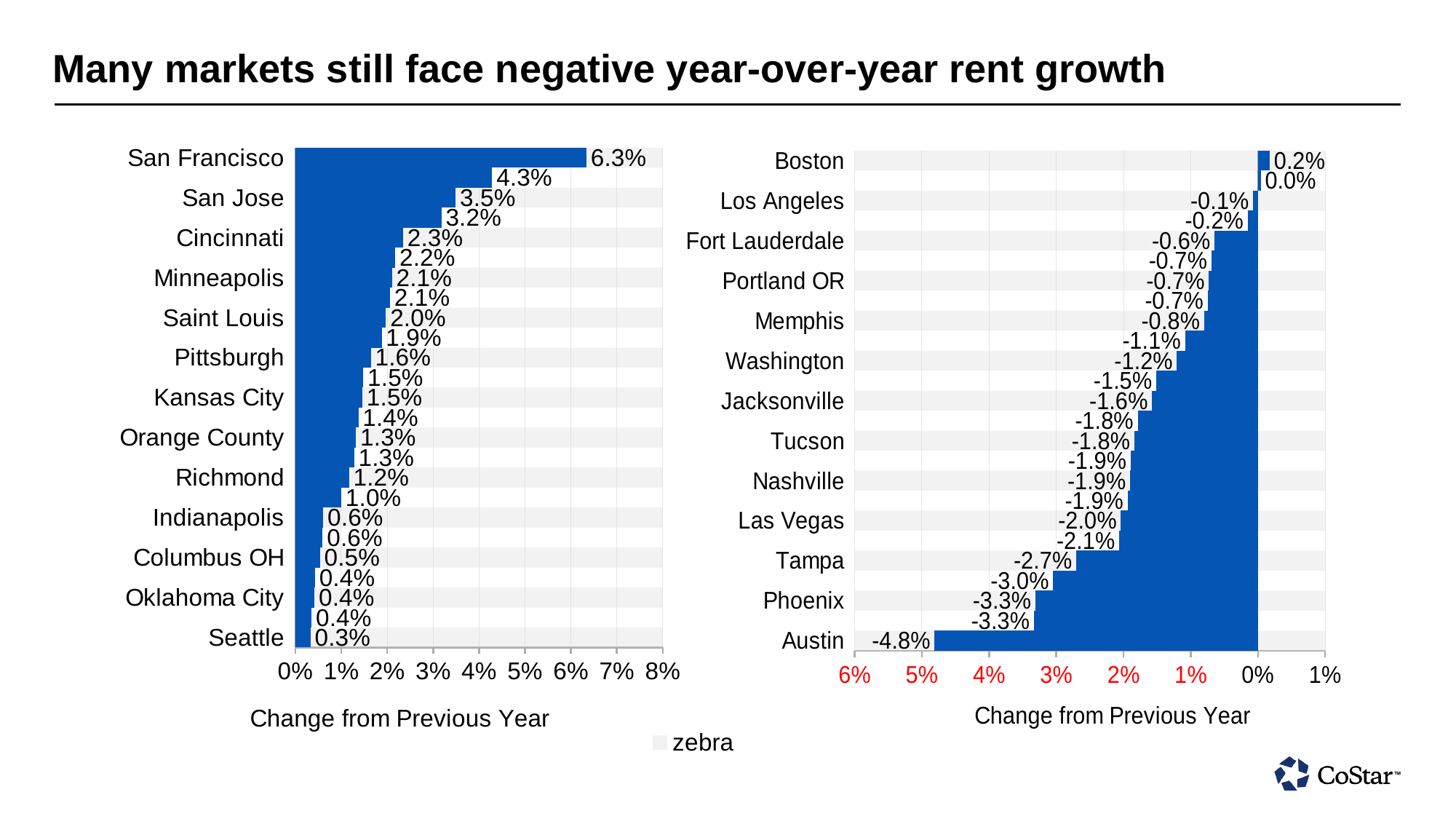
What is the x-axis title of the right chart? Change from Previous Year In the left chart, what is the difference between the values for San Francisco and San Jose? 2.8% In the right chart, what is the change from previous year for Austin? -4.8% In the left chart, which has a larger change from previous year, Cincinnati or Pittsburgh? Cincinnati What kind of chart is the left chart? Bar chart In the right chart, what is the difference between the values for Boston and Las Vegas? 2.2% In the left chart, which market has the highest change from previous year? San Francisco In the right chart, which market has the lowest change from previous year? Austin In the left chart, what is the change from previous year for Kansas City? 1.5% In the right chart, what is the change from previous year for Washington? -1.2% In the left chart, what is the change from previous year for San Francisco? 6.3% In the right chart, which has a larger change from previous year, Tampa or Phoenix? Tampa